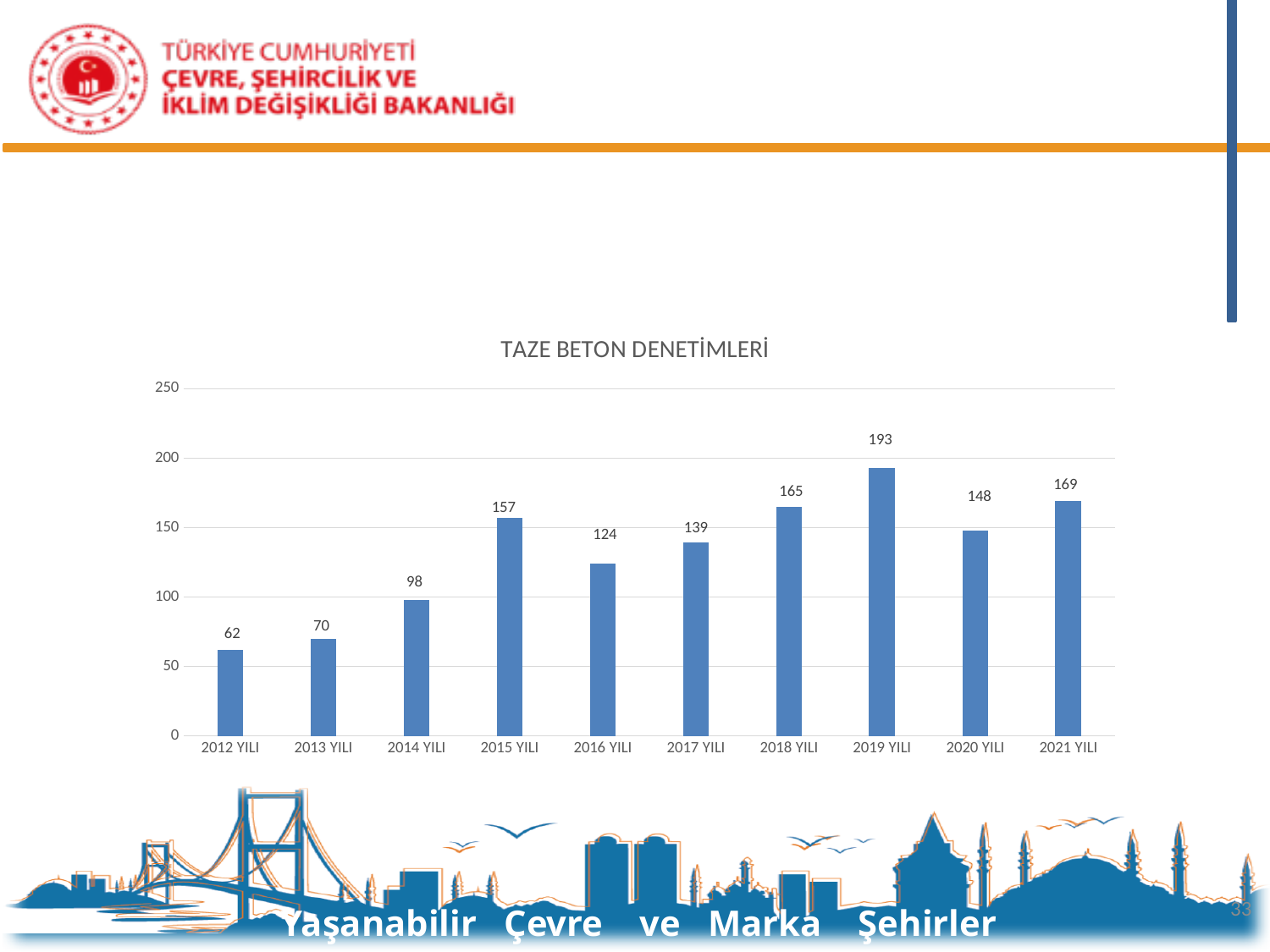
Which is larger, the value for 2015 YILI or the value for 2017 YILI? 2015 YILI Is the value for 2014 YILI greater or less than 100? less What is the value for 2012 YILI? 62 What is the value for 2016 YILI? 124 How many years are shown on the x axis? 10 What is the value for 2019 YILI? 193 What is the difference between the values for 2019 YILI and 2020 YILI? 45 Which year has the lowest value? 2012 YILI Do the values rise or fall from 2012 YILI to 2015 YILI? rise Which year has the highest value? 2019 YILI What kind of chart is this? bar chart What is the title of the chart? TAZE BETON DENETİMLERİ